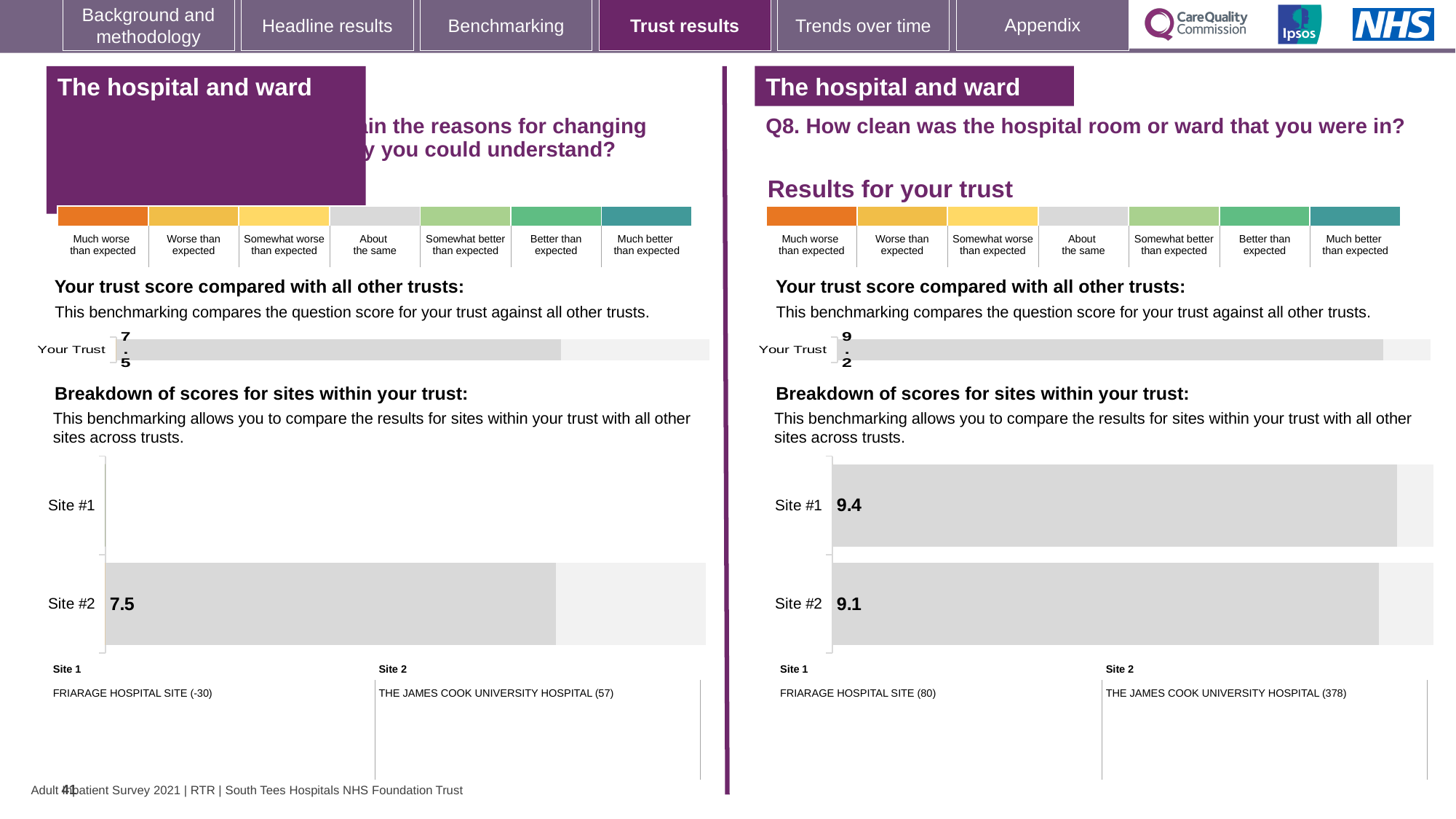
On the left-hand chart, what is the score shown for Your Trust? 7.5 On the right-hand Q8 site breakdown chart, what is the difference between the Site #1 and Site #2 scores? 0.3 On the right-hand Q8 charts, is the Site #1 score or the Your Trust score larger? Site #1 On the left-hand site breakdown chart, which site has no bar or score displayed? Site #1 On the left-hand site breakdown chart, what is the score for Site #2? 7.5 How many sites are listed on the right-hand Q8 site breakdown chart? 2 On the right-hand Q8 chart, which hospital is listed as Site 1? FRIARAGE HOSPITAL SITE What kind of chart is the right-hand Q8 site breakdown chart? Bar chart On the right-hand chart for Q8 (how clean was the hospital room or ward), what is the score shown for Your Trust? 9.2 On the right-hand Q8 site breakdown chart, what is the score for Site #2? 9.1 On the right-hand Q8 site breakdown chart, which site has the higher score? Site #1 On the right-hand Q8 site breakdown chart, what is the score for Site #1? 9.4